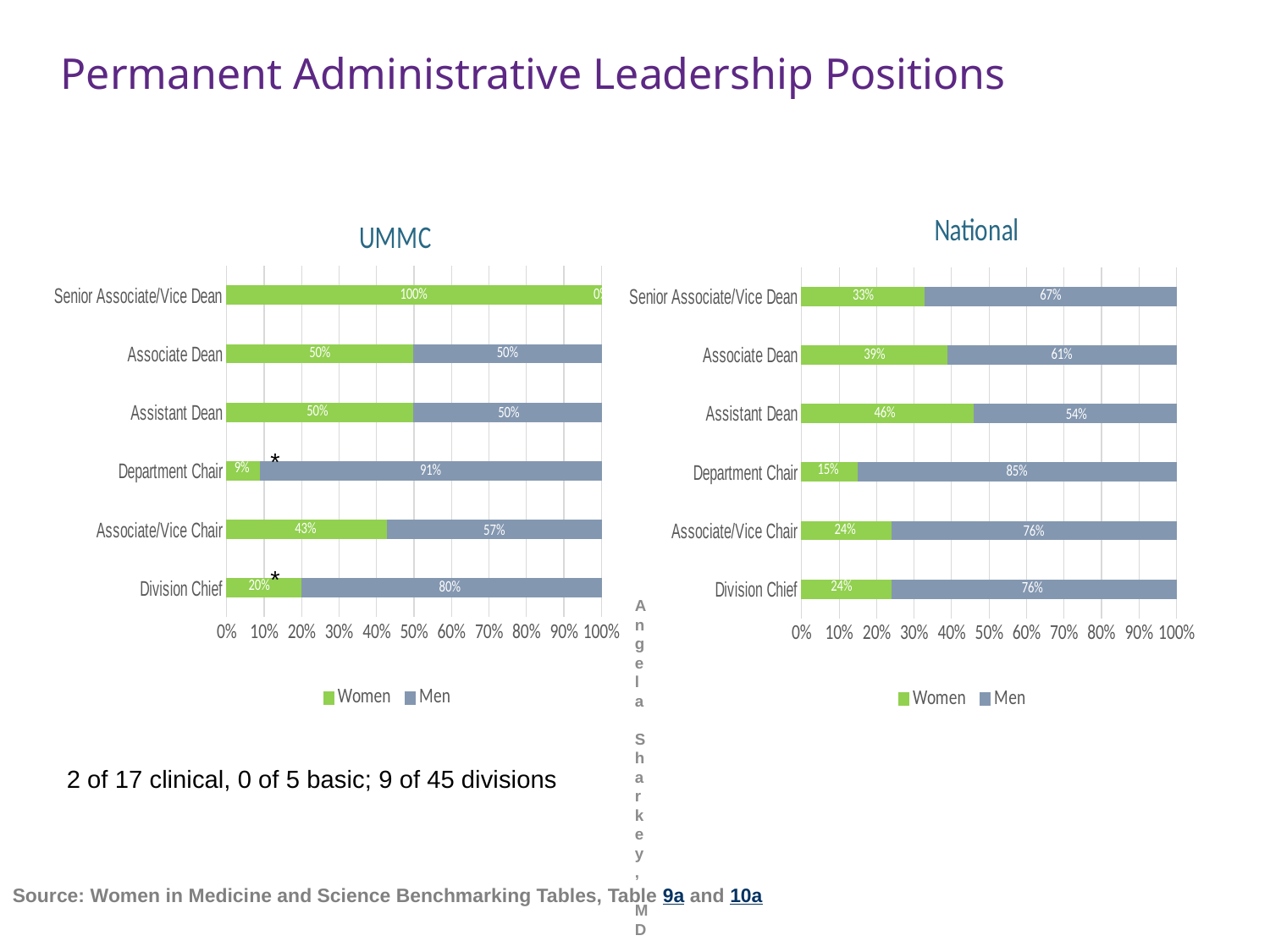
In the National chart, what percentage of Assistant Dean positions are held by men? 54% What type of chart is the UMMC chart? Stacked bar chart In the UMMC chart, what is the Men value for Division Chief? 80% How many series does the legend of the UMMC chart list? 2 Is the Women value for Associate/Vice Chair larger in the UMMC chart or the National chart? UMMC In the National chart, which position has the lowest share of women? Department Chair How many positions (categories) are shown in the National chart? 6 In the National chart, what is the difference between the Men and Women values for Associate Dean? 22% In the UMMC chart, which position has the highest share of women? Senior Associate/Vice Dean In the UMMC chart, what is the total of the Women and Men values for Associate Dean? 100% In the National chart, what is the Women value for Senior Associate/Vice Dean? 33% In the UMMC chart, what percentage of Department Chair positions are held by women? 9%